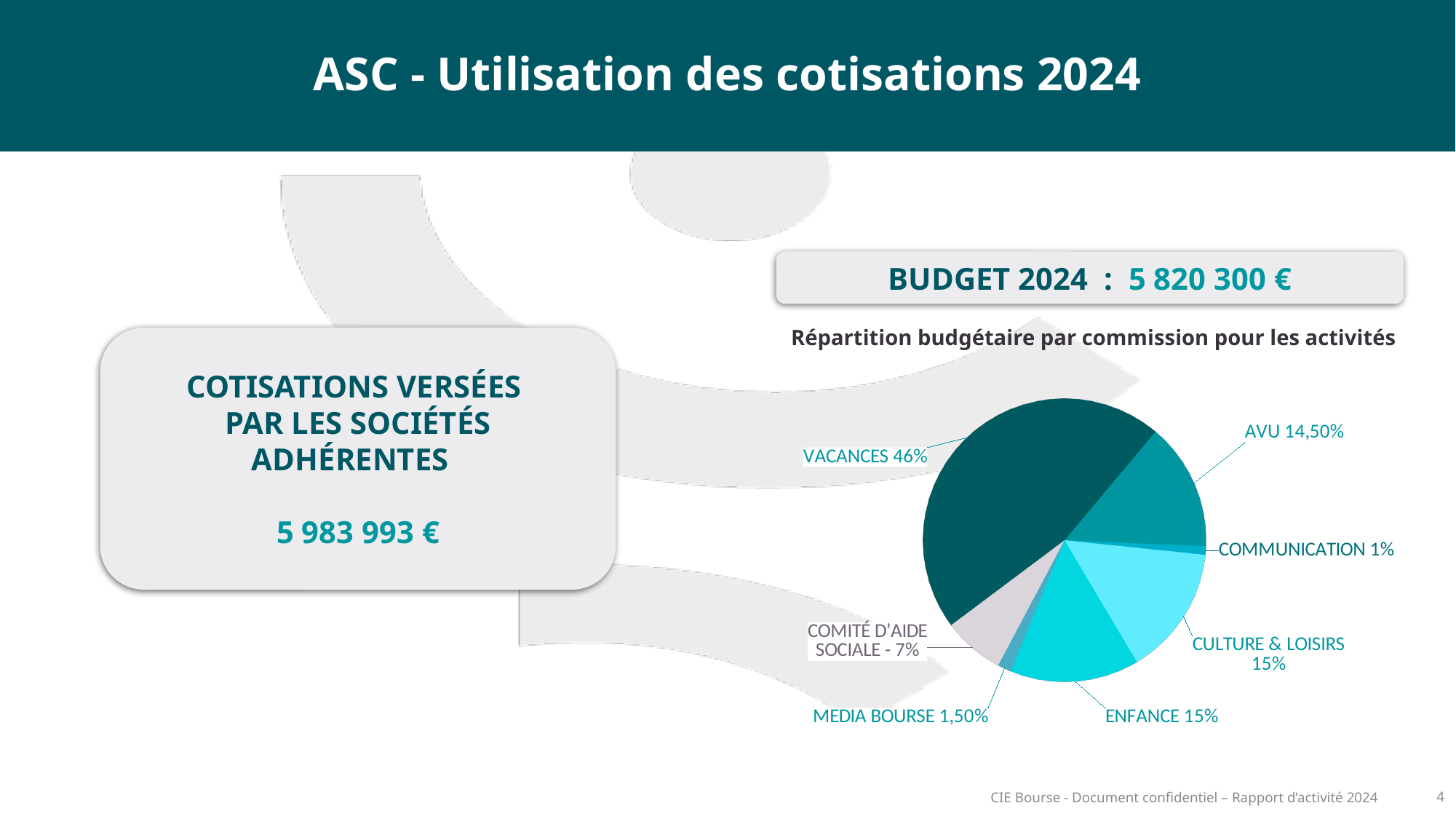
What is the difference in percentage points between VACANCES and AVU? 31,50 What share of the budget goes to COMITÉ D'AIDE SOCIALE? 7% What share of the budget goes to VACANCES? 46% Which is larger, the share for COMITÉ D'AIDE SOCIALE or the share for MEDIA BOURSE? COMITÉ D'AIDE SOCIALE Which commission has the smallest share of the pie? COMMUNICATION What share of the budget goes to COMMUNICATION? 1% What share of the budget goes to MEDIA BOURSE? 1,50% What share of the budget goes to AVU? 14,50% What is the title shown above the pie chart? Répartition budgétaire par commission pour les activités How many slices does the pie chart have? 7 Which commission has the largest share of the pie? VACANCES What kind of chart is shown on the slide? pie chart